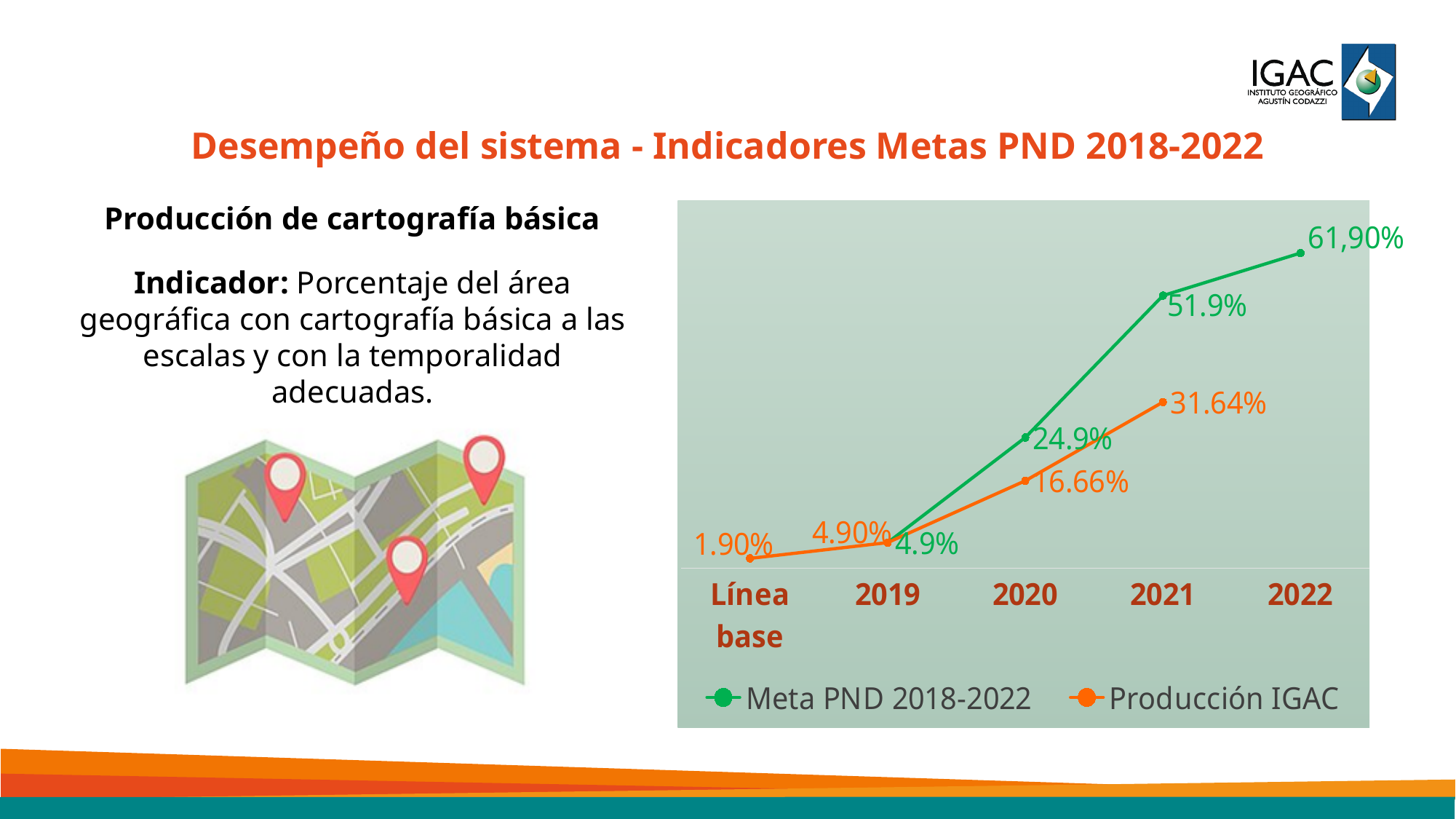
What is the Producción IGAC value for Línea base? 1.90% Which category has the lowest Producción IGAC value? Línea base What type of chart is shown on the slide? Line chart What is the Producción IGAC value for 2020? 16.66% How many categories are shown on the x axis? 5 In which year does the Meta PND 2018-2022 series reach its highest value? 2022 What is the Meta PND 2018-2022 value for 2022? 61,90% In 2021, which is larger: Meta PND 2018-2022 or Producción IGAC? Meta PND 2018-2022 What is the Producción IGAC value for 2021? 31.64% What is the difference between the Meta PND 2018-2022 value and the Producción IGAC value in 2021? 20.26 percentage points How many series does the chart legend list? 2 What is the Meta PND 2018-2022 value for 2020? 24.9%